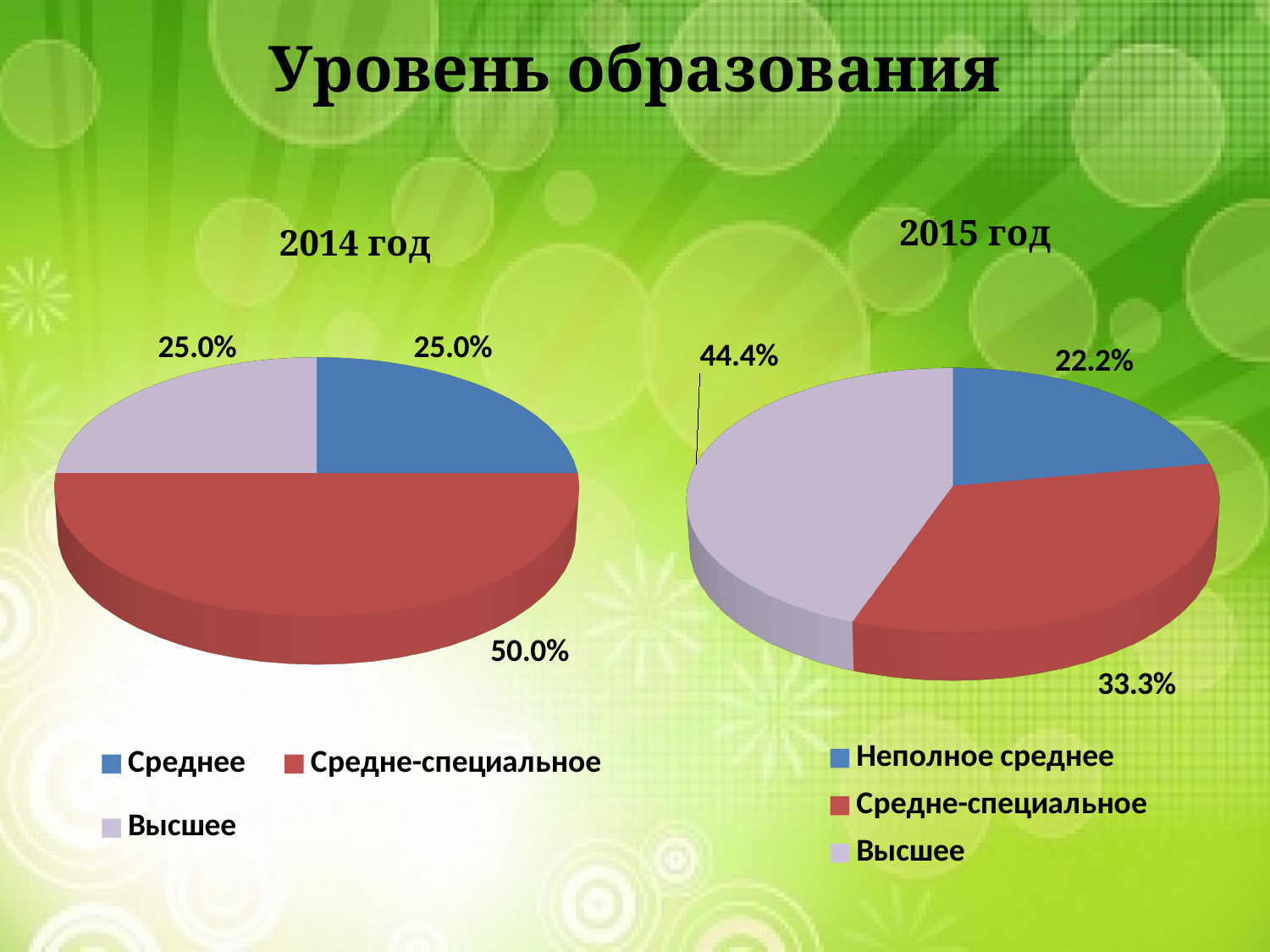
In the "2015 год" chart, which category has the largest share? Высшее In the "2014 год" chart, which category has the largest share? Средне-специальное In the "2014 год" chart, what share does Высшее have? 25.0% How many categories does the "2014 год" chart show? 3 In the "2015 год" chart, which is larger: Средне-специальное or Неполное среднее? Средне-специальное What type of chart is the "2015 год" chart? Pie chart In the "2015 год" chart, what share does Неполное среднее have? 22.2% In the "2014 год" chart, what share does Средне-специальное have? 50.0% In the "2015 год" chart, what share does Средне-специальное have? 33.3% In the "2015 год" chart, what is the difference between the shares of Высшее and Средне-специальное? 11.1% In the "2015 год" chart, what share does Высшее have? 44.4% In the "2015 год" chart, which category has the smallest share? Неполное среднее